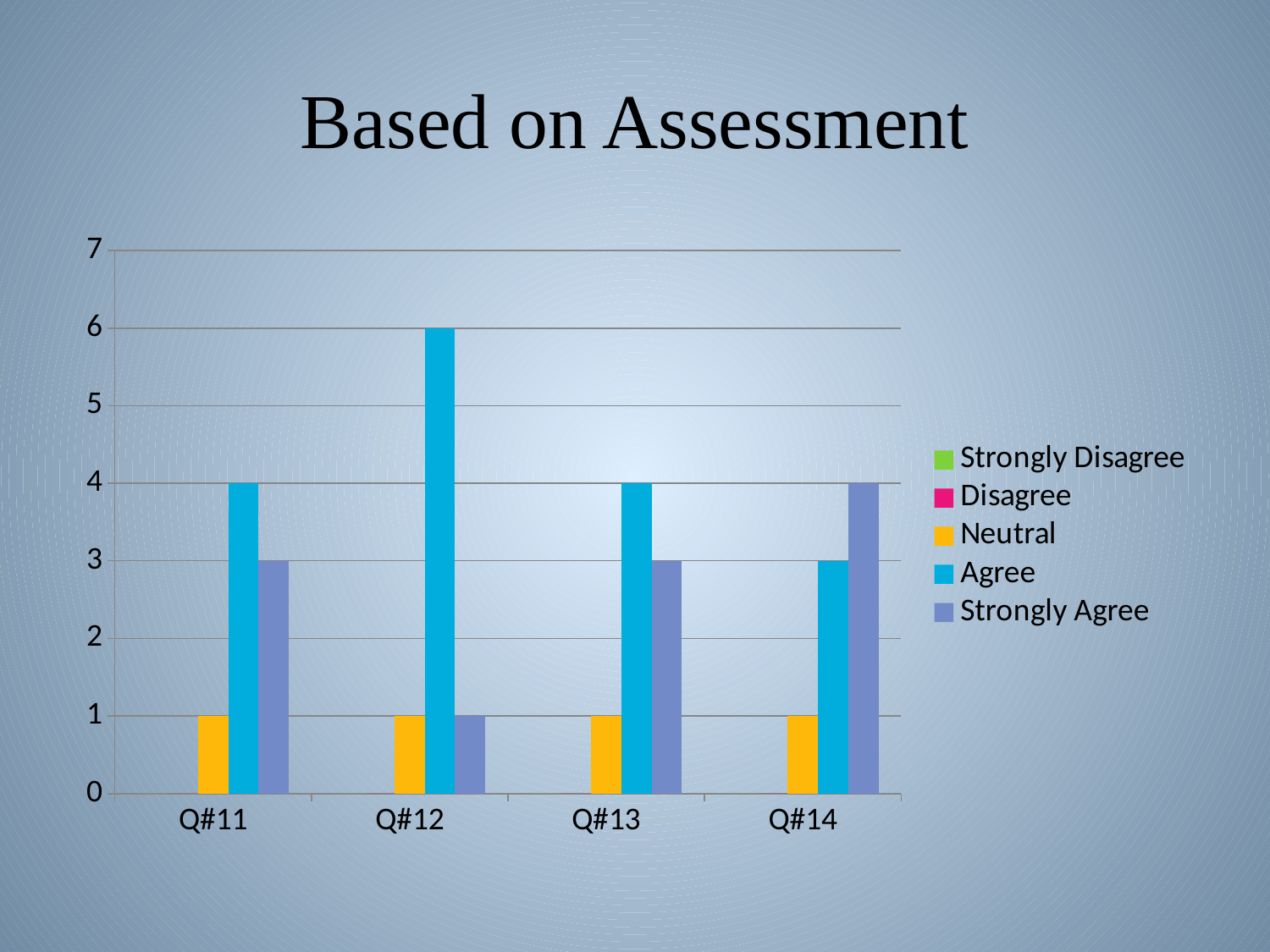
How many question categories are shown on the x axis? 4 What is the Neutral value for Q#13? 1 For Q#14, which is larger: the Agree value or the Strongly Agree value? Strongly Agree Which question has the highest Agree value? Q#12 What is the Strongly Agree value for Q#14? 4 What type of chart is shown on the slide? bar chart What is the Agree value for Q#12? 6 What is the difference between the Agree value for Q#12 and the Agree value for Q#14? 3 Which question has the lowest Strongly Agree value? Q#12 How many series does the legend list? 5 What is the title of the chart? Based on Assessment Is the Agree value for Q#12 greater or less than 5? greater